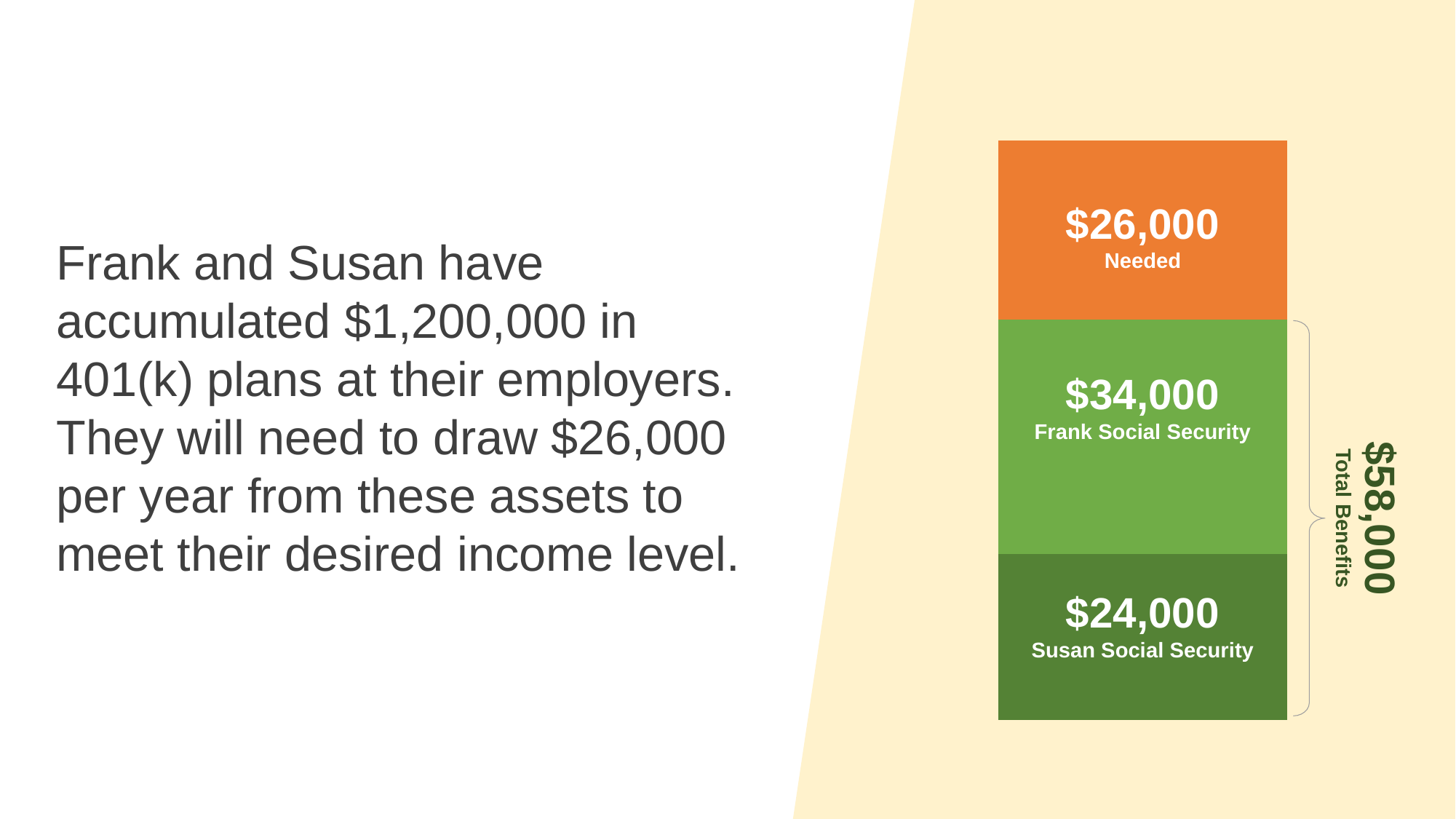
What is the difference between Frank Social Security and the Needed amount? $8,000 Which segment of the stacked bar has the smallest value? Susan Social Security What value is shown for Frank Social Security? $34,000 What value is shown for Susan Social Security? $24,000 What value is shown for the Needed segment of the stacked bar? $26,000 What total is labelled for the two Social Security segments combined? $58,000 Which is larger, the Needed amount or Susan Social Security? Needed What is the difference between Frank Social Security and Susan Social Security? $10,000 How many segments make up the stacked bar? 3 Which segment of the stacked bar has the largest value? Frank Social Security What is the total of all three segments in the stacked bar? $84,000 What colour is the Needed segment of the stacked bar? Orange